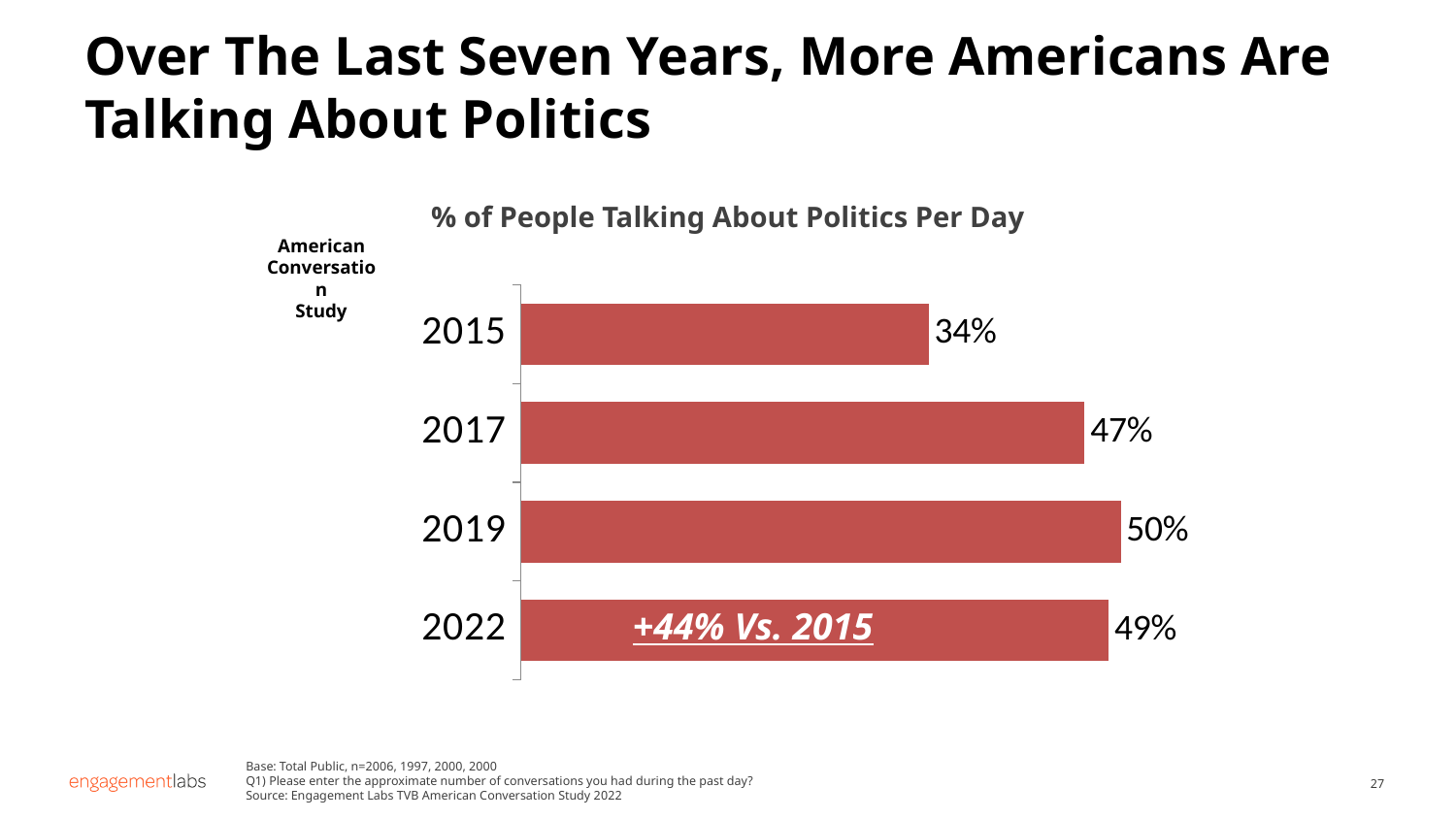
What type of chart is shown on the slide? Bar chart What is the value shown for 2022? 49% How many years are shown in the chart? 4 What is the value shown for 2017? 47% Which year has the lowest percentage of people talking about politics per day? 2015 What percentage of people were talking about politics per day in 2015? 34% What is the difference in percentage points between 2019 and 2017? 3 Which year has a larger value, 2015 or 2017? 2017 Which year has the highest percentage of people talking about politics per day? 2019 What is the title of the chart? % of People Talking About Politics Per Day What is the difference in percentage points between 2022 and 2015? 15 What is the value shown for 2019? 50%